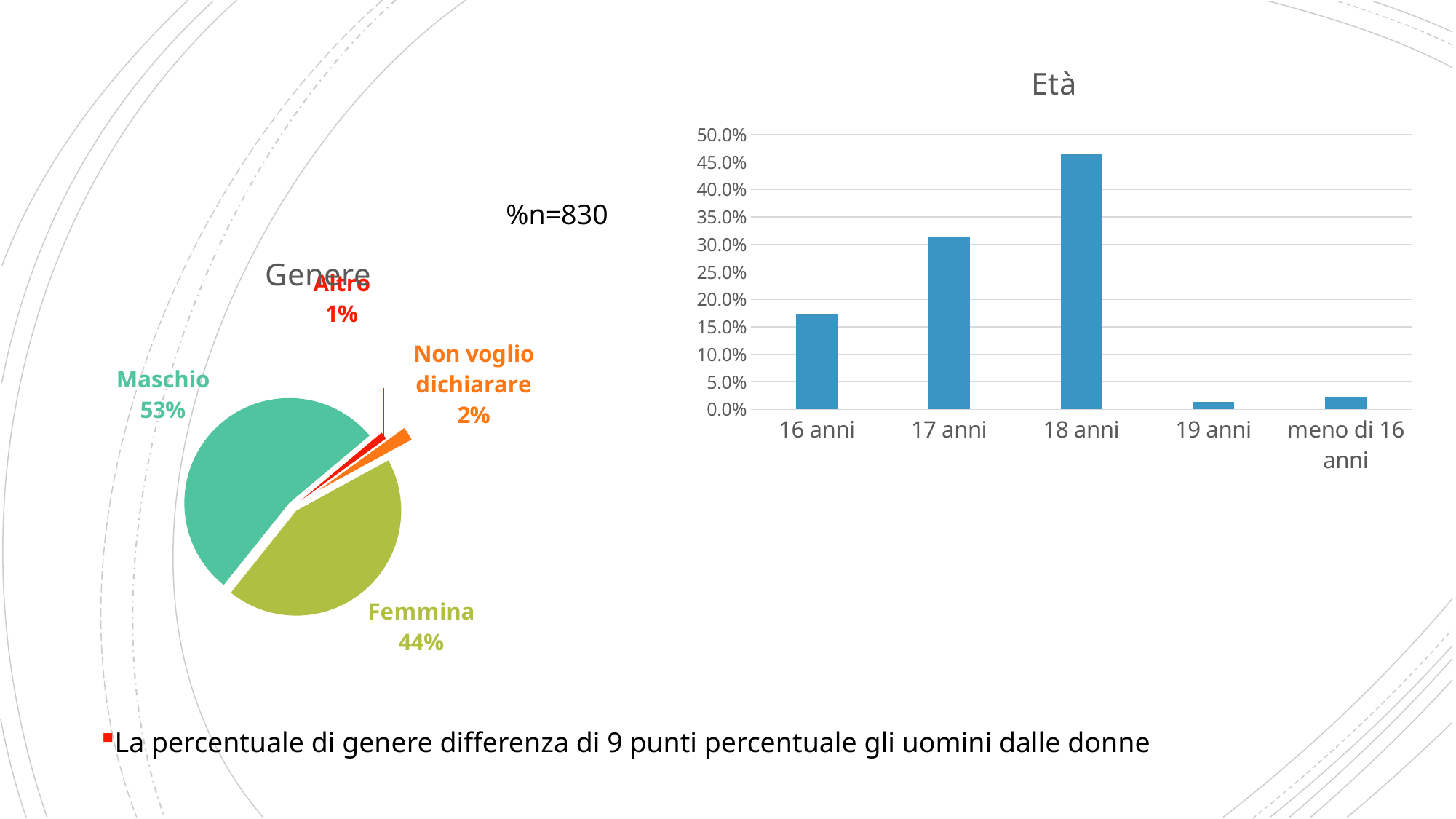
How many slices does the Genere pie chart have? 4 In the Età chart, which age category has the highest value? 18 anni What kind of chart is the Età chart? Bar chart In the Genere pie chart, what percentage is Maschio? 53% In the Genere pie chart, which category has the largest share? Maschio In the Età chart, is the value for 18 anni greater or less than 40.0%? greater How many age categories are shown in the Età chart? 5 In the Genere pie chart, what percentage is Non voglio dichiarare? 2% In the Età chart, is the value for 16 anni greater or less than 20.0%? less In the Genere pie chart, which category has the smallest share? Altro In the Genere pie chart, what percentage is Femmina? 44% In the Genere pie chart, what is the difference in percentage points between Maschio and Femmina? 9 percentage points